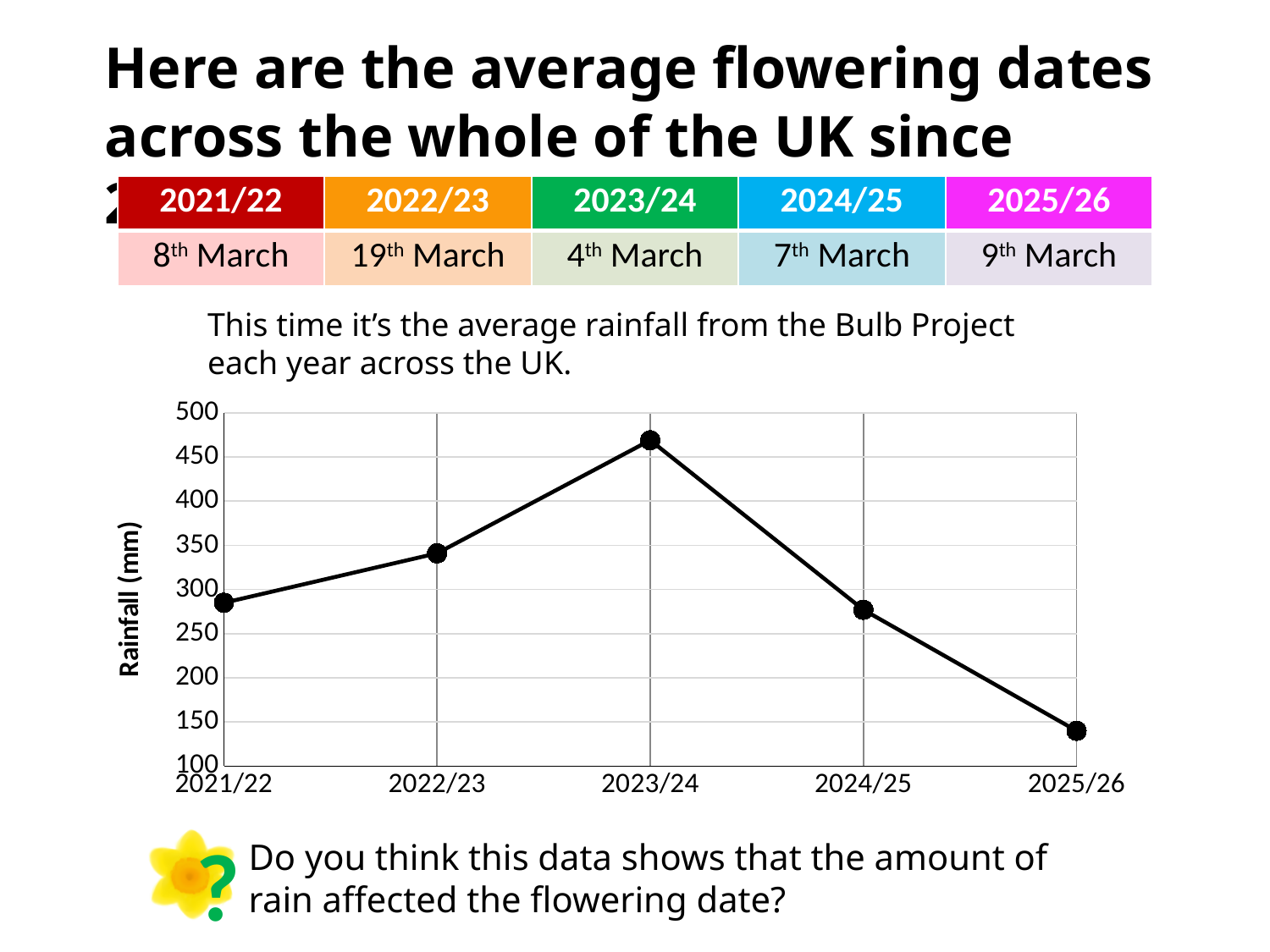
Is the rainfall value for 2023/24 greater or less than 400? greater Does the rainfall rise or fall from 2023/24 to 2025/26? fall What is the label on the vertical axis of the chart? Rainfall (mm) Is the rainfall value for 2024/25 greater or less than 300? less Which year has the highest average rainfall on the chart? 2023/24 What kind of chart is shown on the slide? line chart How many years are plotted on the rainfall chart? 5 Does the rainfall rise or fall from 2021/22 to 2023/24? rise Which year has the lowest average rainfall on the chart? 2025/26 Is the rainfall value for 2022/23 greater or less than 300? greater Which year has higher rainfall, 2022/23 or 2024/25? 2022/23